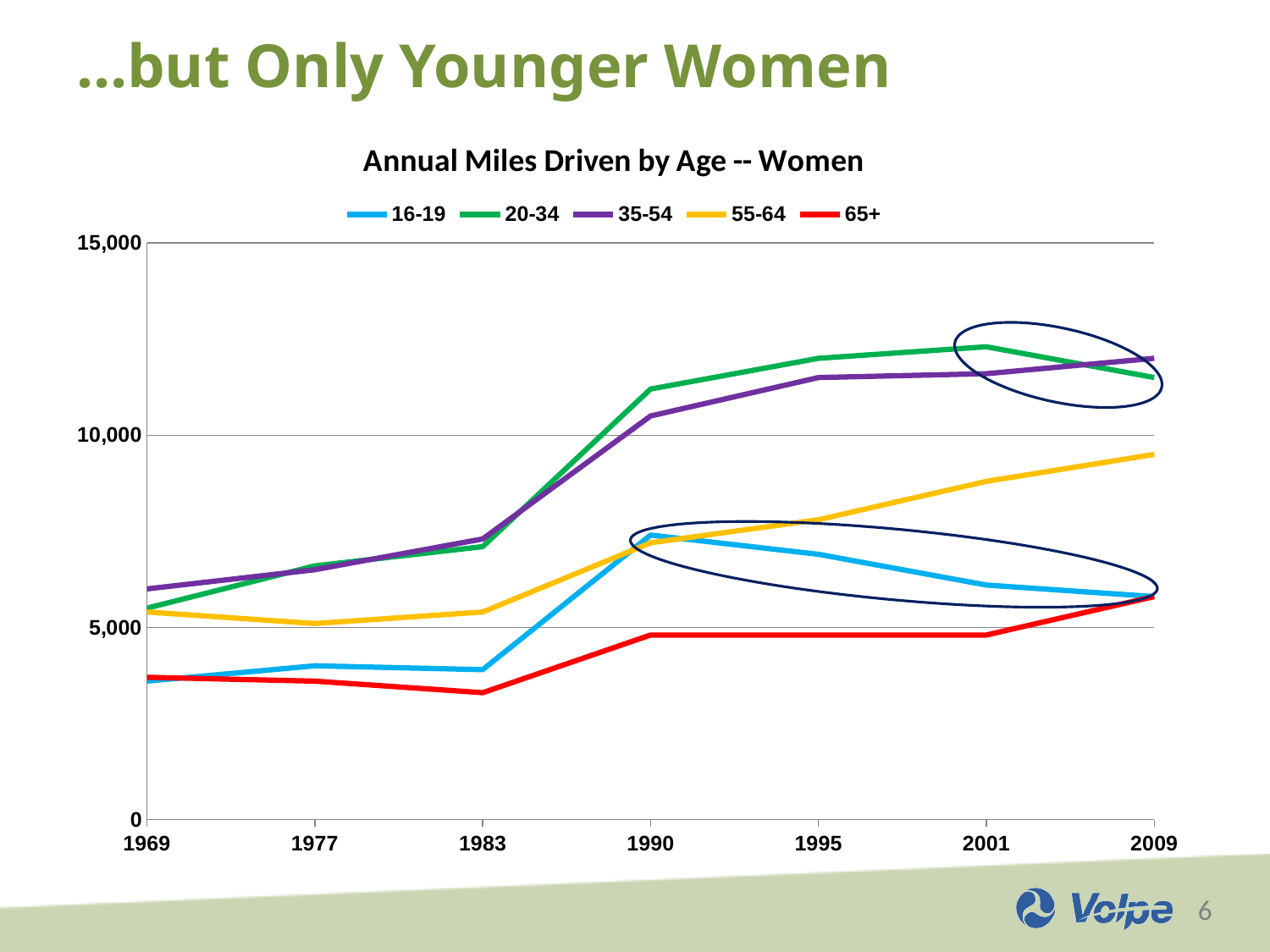
Which age group has the highest value in 2009? 35-54 Which age group is shown by the red line? 65+ Is the value for the 20-34 group in 2001 greater or less than 10,000? greater How many series does the legend list? 5 What is the title of the chart? Annual Miles Driven by Age -- Women Is the value for the 55-64 group in 2009 greater or less than 10,000? less Which age group has the lowest value in 1983? 65+ Is the value for the 65+ group in 1983 greater or less than 5,000? less How many years are marked along the x axis? 7 What kind of chart is shown on the slide? Line chart Does the value for the 16-19 group rise or fall from 1990 to 2009? Fall In 1969, which is larger: the value for 35-54 or the value for 16-19? 35-54